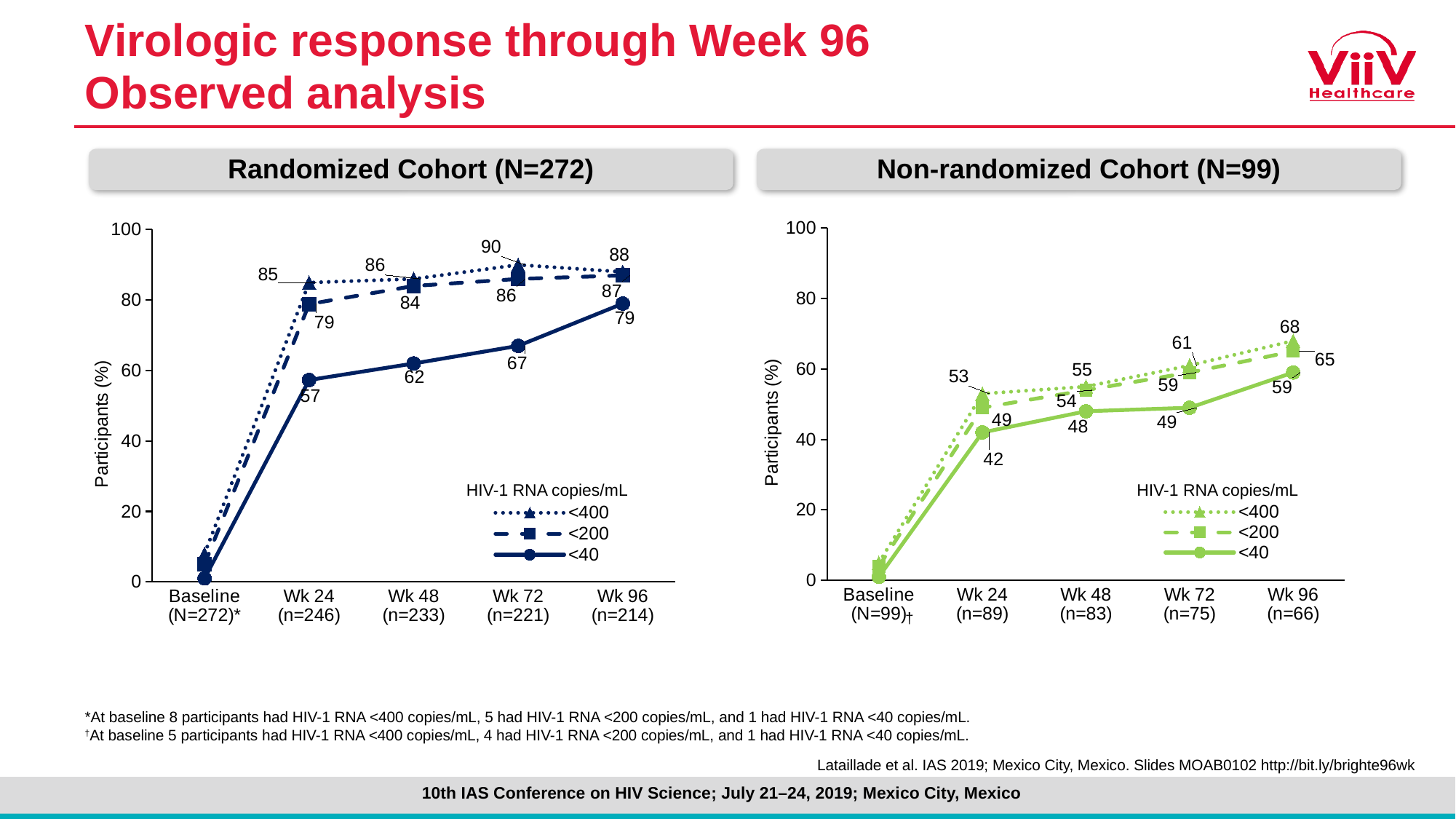
In the Non-randomized Cohort chart, does the <40 series rise or fall from Wk 24 to Wk 96? Rise In the Randomized Cohort chart, at which time point does the <400 series reach its highest value? Wk 72 In the Non-randomized Cohort chart, which is larger at Wk 72: the <200 value or the <40 value? <200 What type of chart is used for the Non-randomized Cohort? Line chart In the Randomized Cohort chart, what is the difference between the <400 and <40 values at Wk 24? 28 In the Randomized Cohort chart, what is the value for the <400 series at Wk 72? 90 In the Non-randomized Cohort chart, what is the difference between the <400 value at Wk 96 and at Wk 24? 15 In the Randomized Cohort chart, what is the value for the <40 series at Wk 96? 79 How many series does the legend list in the Randomized Cohort chart? 3 How many time points are shown on the x axis of the Non-randomized Cohort chart? 5 In the Non-randomized Cohort chart, what is the value for the <200 series at Wk 48? 54 In the Non-randomized Cohort chart, what is the value for the <40 series at Wk 24? 42